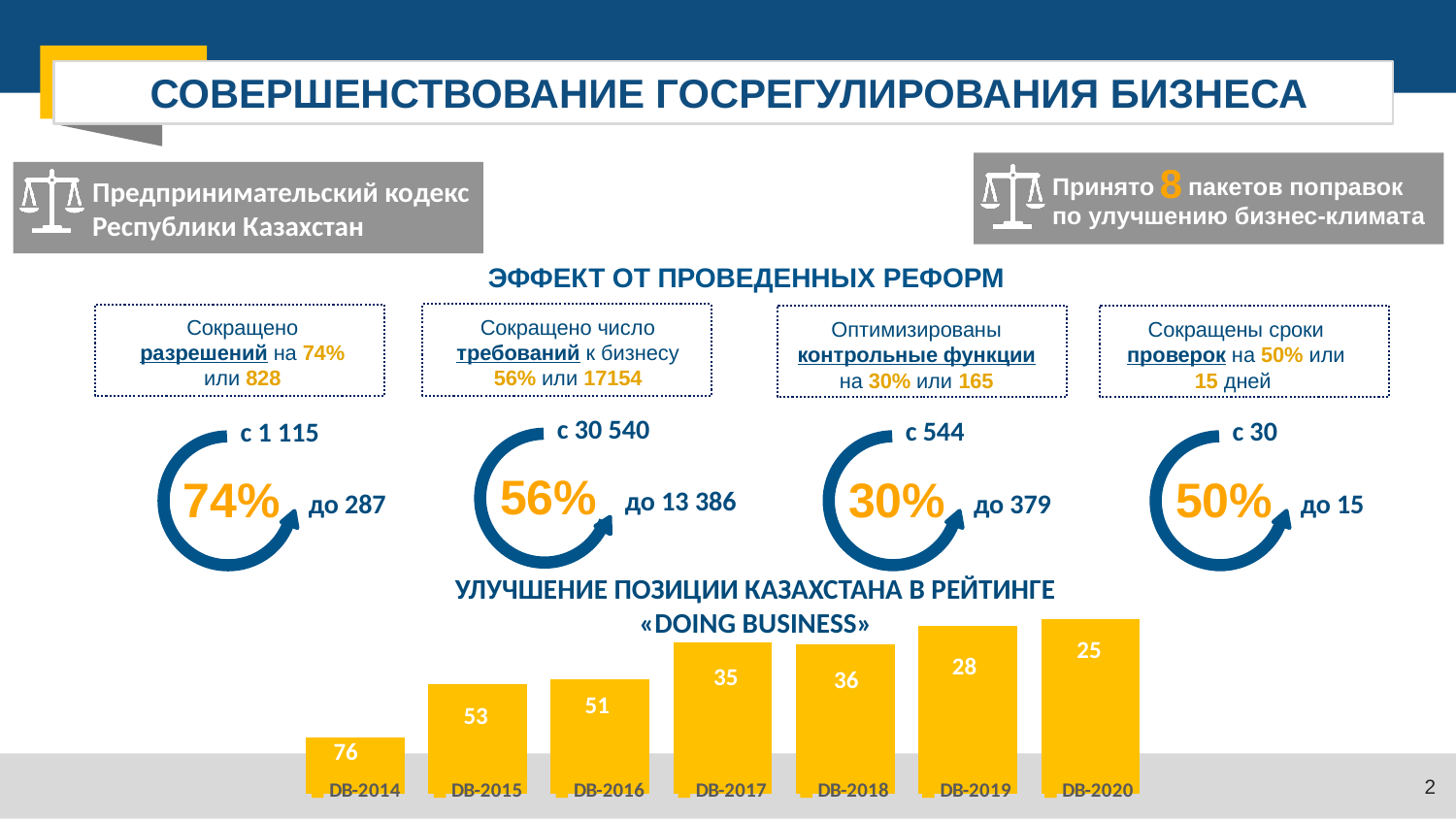
In the «Doing Business» bar chart, do the printed values generally rise or fall from DB-2014 to DB-2020? Fall In the «Doing Business» bar chart, which category has the lowest printed value? DB-2020 How many categories are shown in the «Doing Business» bar chart? 7 In the «Doing Business» bar chart, what is the value for DB-2014? 76 What colour are the bars in the «Doing Business» bar chart? Yellow In the «Doing Business» bar chart, what is the value for DB-2019? 28 In the «Doing Business» bar chart, what is the difference between the values for DB-2014 and DB-2020? 51 In the «Doing Business» bar chart, which has the larger value, DB-2015 or DB-2016? DB-2015 What kind of chart is used to show Kazakhstan's position in the «Doing Business» rating? Bar chart In the «Doing Business» bar chart, which category has the highest printed value? DB-2014 In the «Doing Business» bar chart, what is the value for DB-2020? 25 In the «Doing Business» bar chart, what is the value for DB-2017? 35